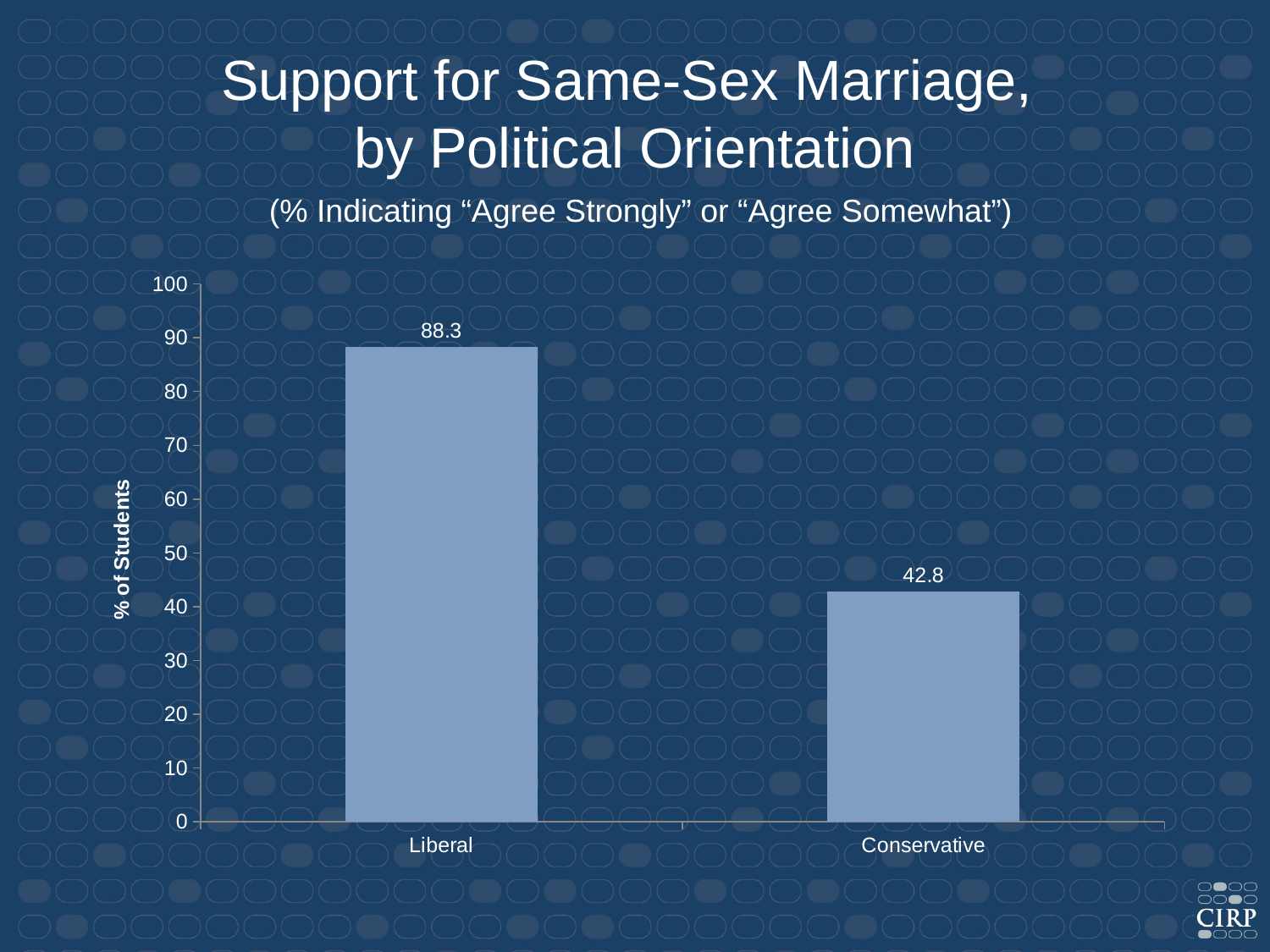
Which is larger, the value for Liberal or the value for Conservative? Liberal What is the value for Conservative? 42.8 What is the label of the y axis? % of Students What is the title of the chart? Support for Same-Sex Marriage, by Political Orientation What is the difference between the values for Liberal and Conservative? 45.5 Is the value for Conservative greater or less than 50? less What is the value for Liberal? 88.3 Which category has the lowest value? Conservative What kind of chart is shown on the slide? bar chart Is the value for Liberal greater or less than 80? greater How many categories are shown on the x axis? 2 Which category has the highest value? Liberal